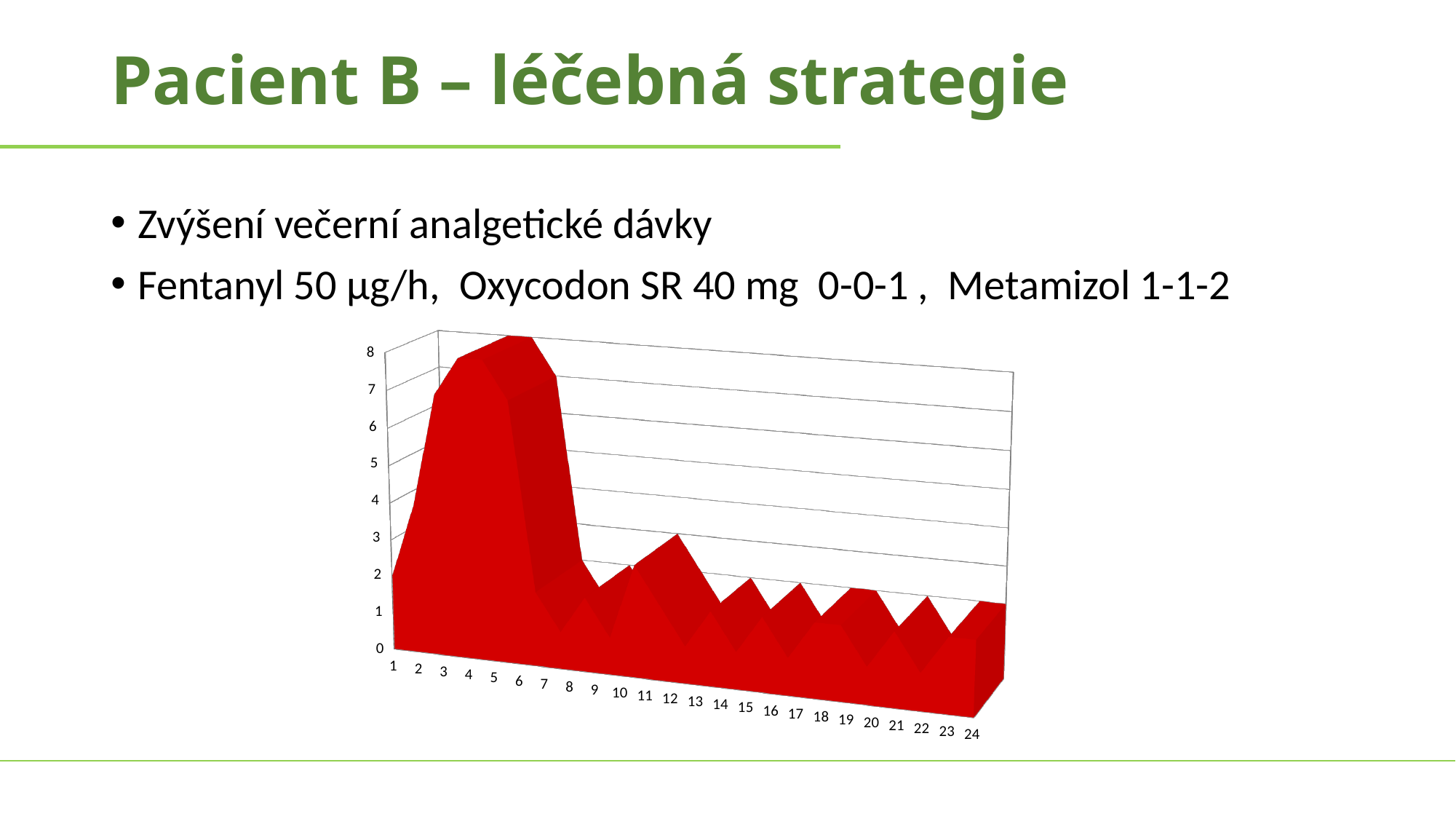
Is the value at x = 20 greater or less than 4? less Which is larger, the value at x = 2 or the value at x = 20? x = 2 Is the value at x = 4 greater or less than 5? greater Which is larger, the value at x = 3 or the value at x = 10? x = 3 Do the values rise or fall from x = 1 to x = 3? rise How many points are plotted along the x axis of the chart? 24 Is the value at x = 3 greater or less than 6? greater What colour is the plotted area in the chart? red Do the values rise or fall from x = 4 to x = 7? fall What kind of chart is shown on the slide? area chart